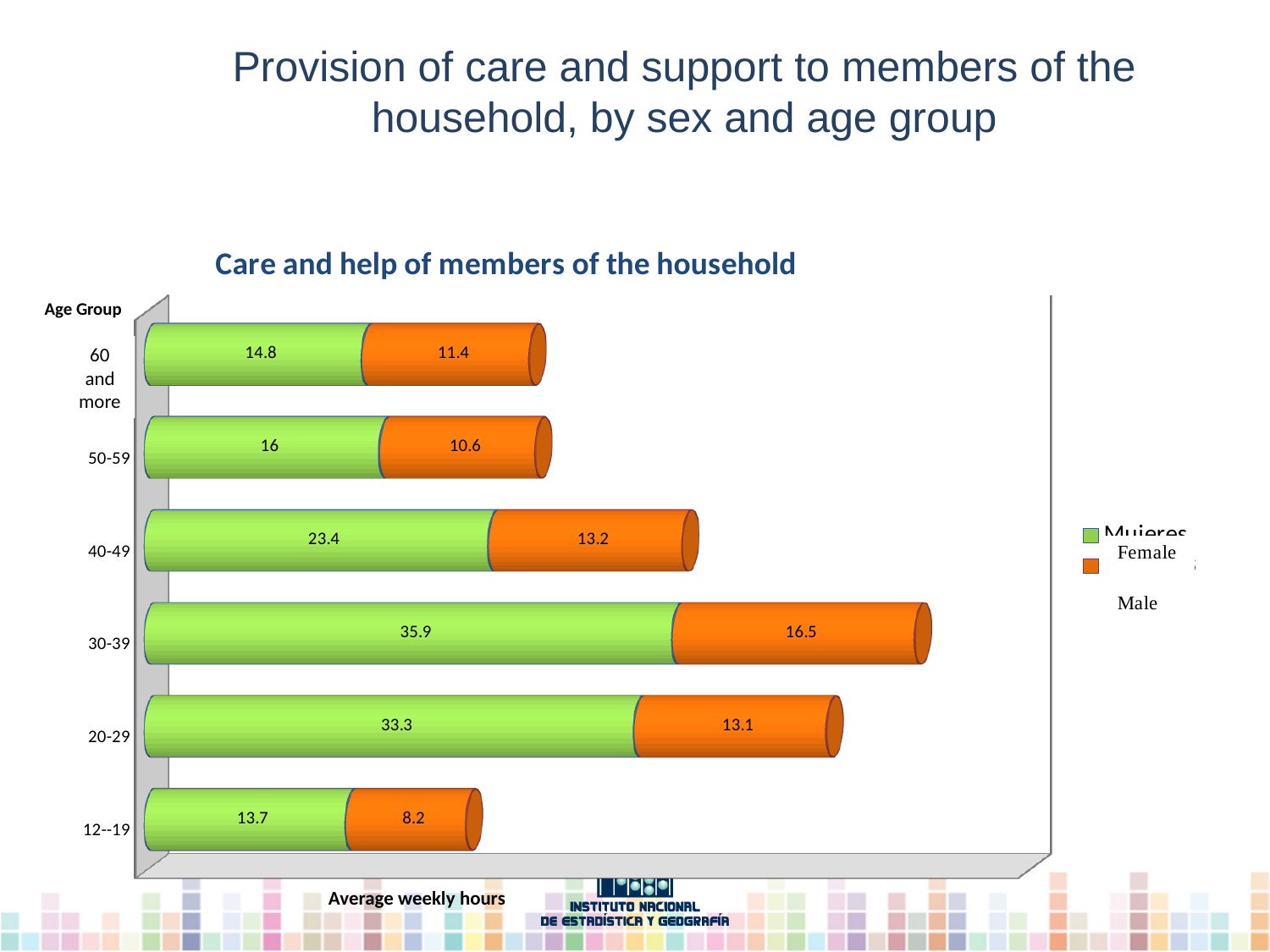
How many series does the legend list? 2 Which age group has the lowest Male value? 12--19 Which age group has the highest Female value? 30-39 What is the total of the stacked bar for the 60 and more age group? 26.2 Which is larger, the Male value for 40-49 or the Male value for 60 and more? Male value for 40-49 What kind of chart is shown on the slide? Stacked bar chart How many age groups are shown on the chart? 6 What is the Female value for the 12--19 age group? 13.7 What is the difference between the Female and Male values for the 20-29 age group? 20.2 What is the Male value for the 50-59 age group? 10.6 What is the label on the horizontal axis of the chart? Average weekly hours What is the Female value for the 30-39 age group? 35.9